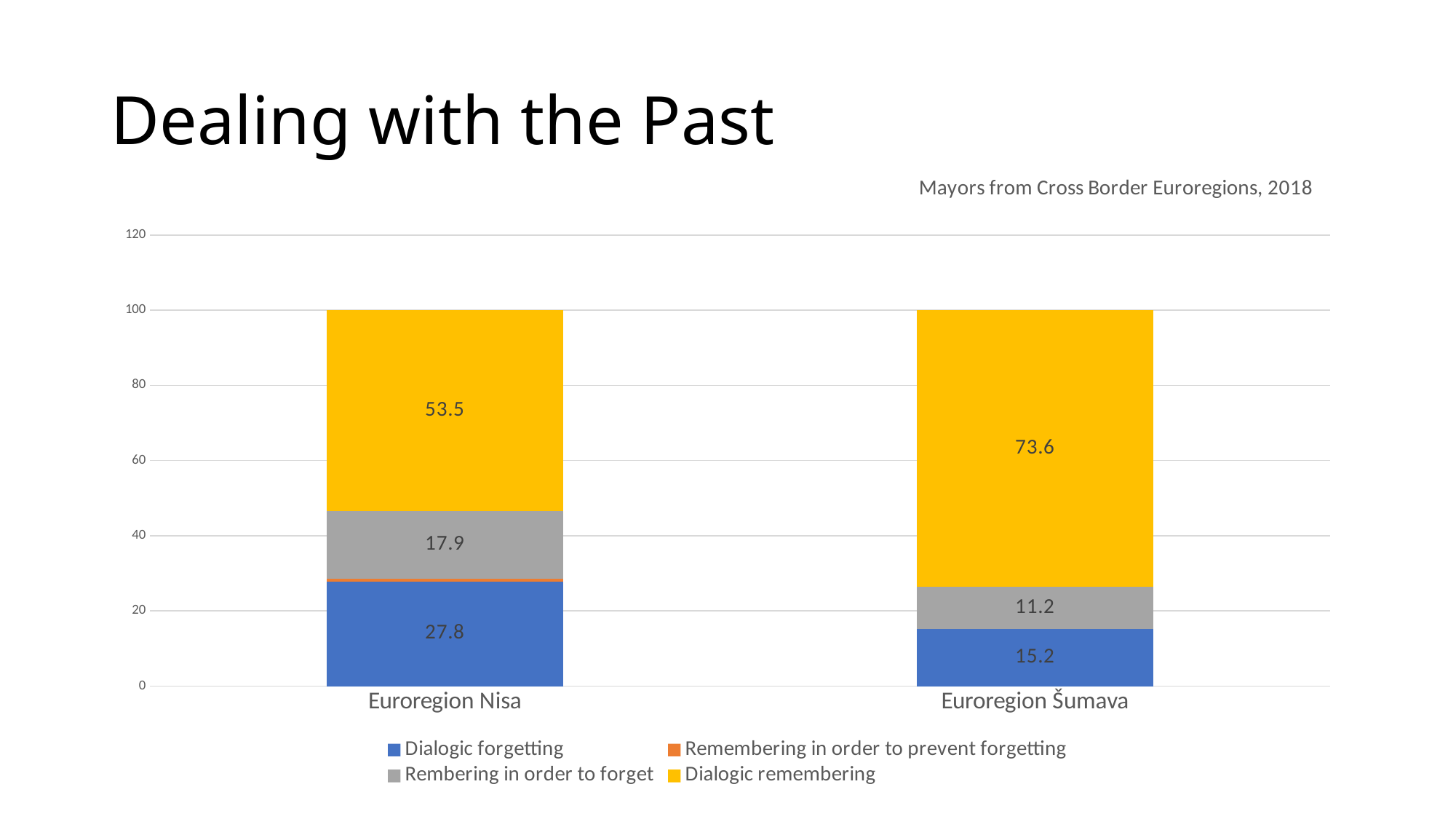
What is the difference between the Dialogic remembering values for Euroregion Šumava and Euroregion Nisa? 20.1 What kind of chart is shown on the slide? Stacked bar chart What is the difference between the Dialogic forgetting values for Euroregion Nisa and Euroregion Šumava? 12.6 How many series does the legend list? 4 How many Euroregions are shown on the x axis? 2 What is the value for Dialogic forgetting in Euroregion Nisa? 27.8 Which Euroregion has the higher value for Dialogic remembering? Euroregion Šumava Which Euroregion has the lower value for Dialogic forgetting? Euroregion Šumava What is the value for Rembering in order to forget in Euroregion Šumava? 11.2 Is the Rembering in order to forget value larger for Euroregion Nisa or Euroregion Šumava? Euroregion Nisa What is the value for Dialogic remembering in Euroregion Nisa? 53.5 What is the value for Dialogic remembering in Euroregion Šumava? 73.6